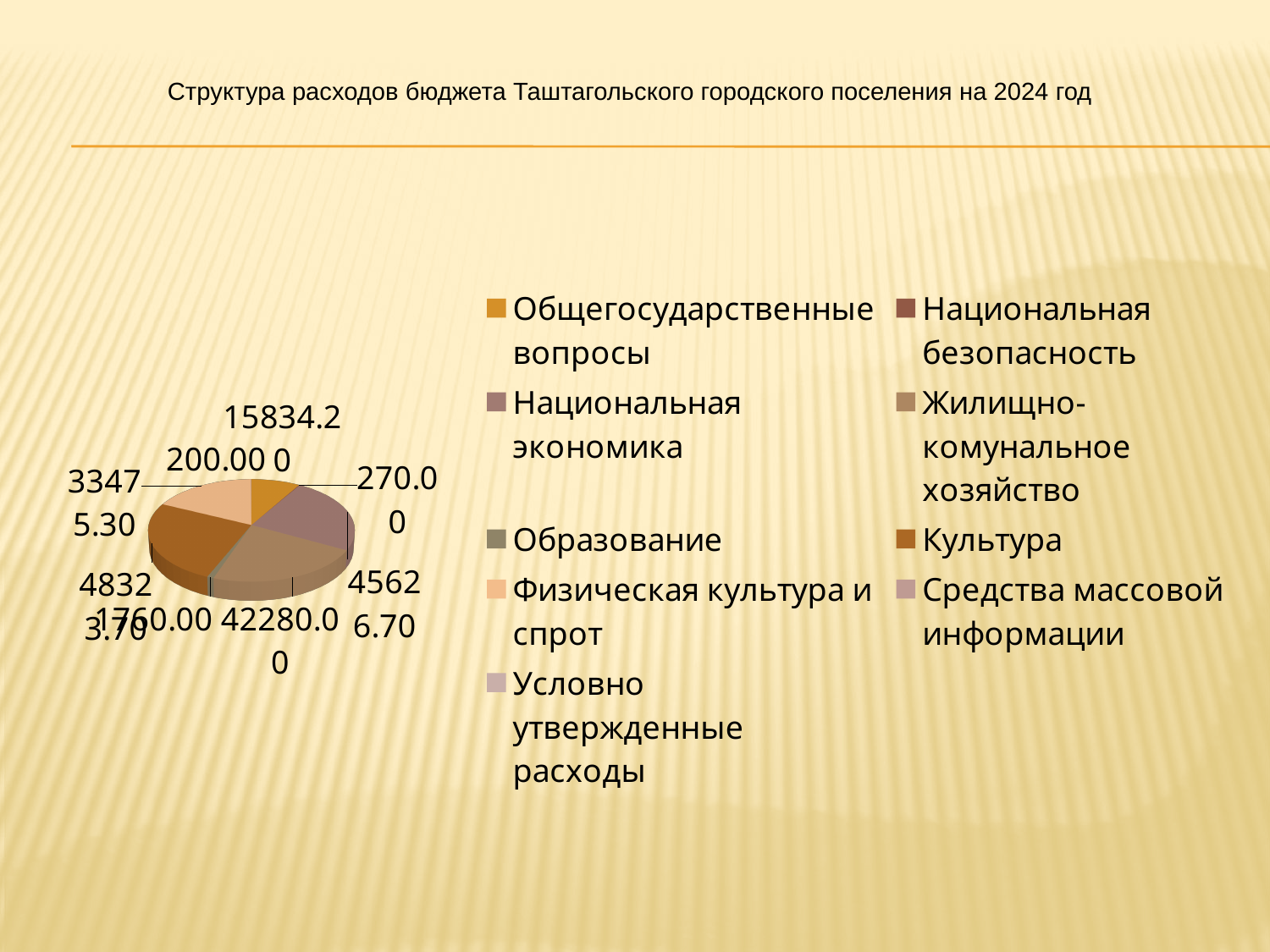
What value is labelled for the Общегосударственные вопросы slice of the pie chart? 15834.2 How many categories does the legend of the pie chart list? 9 Which slice is larger in the pie chart: Культура or Общегосударственные вопросы? Культура Which legend entry of the pie chart is shown in the gold/yellow colour? Общегосударственные вопросы Which slice is larger in the pie chart: Физическая культура и спрот or Общегосударственные вопросы? Физическая культура и спрот What is the title of the slide containing the pie chart? Структура расходов бюджета Таштагольского городского поселения на 2024 год Which slice is larger in the pie chart: Жилищно-коммунальное хозяйство or Общегосударственные вопросы? Жилищно-комунальное хозяйство What kind of chart is shown on the slide? pie chart